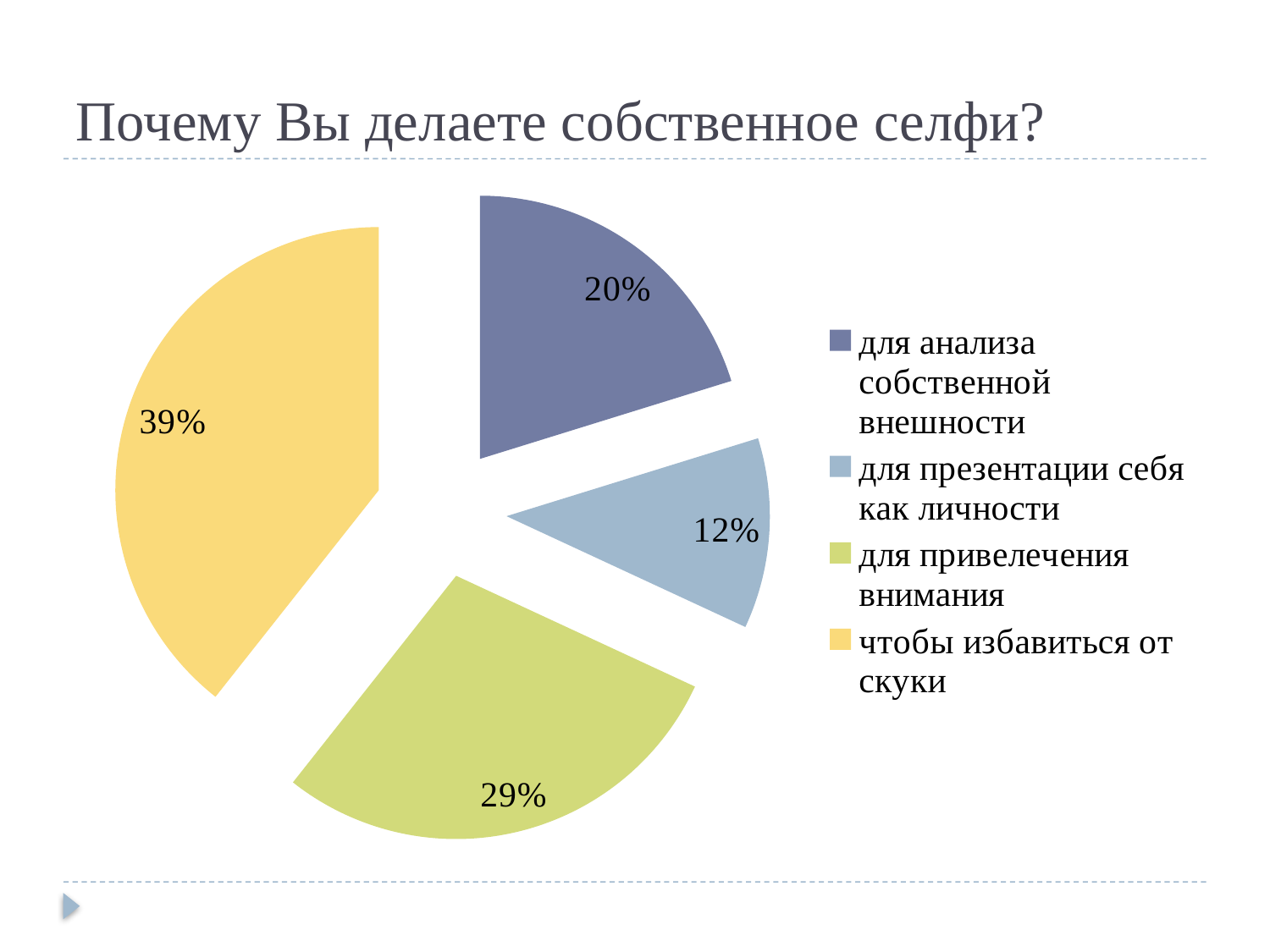
What share of the pie is labelled "для привелечения внимания"? 29% How many entries does the legend list? 4 What is the difference in percentage points between "чтобы избавиться от скуки" and "для привелечения внимания"? 10 Which is larger: the slice for "для анализа собственной внешности" or the slice for "для презентации себя как личности"? для анализа собственной внешности What share of the pie is labelled "для анализа собственной внешности"? 20% Which category has the smallest slice of the pie? для презентации себя как личности What share of the pie is labelled "чтобы избавиться от скуки"? 39% What share of the pie is labelled "для презентации себя как личности"? 12% What kind of chart is shown on the slide? pie chart Which category has the largest slice of the pie? чтобы избавиться от скуки How many slices does the pie chart have? 4 What is the title of the slide containing the chart? Почему Вы делаете собственное селфи?